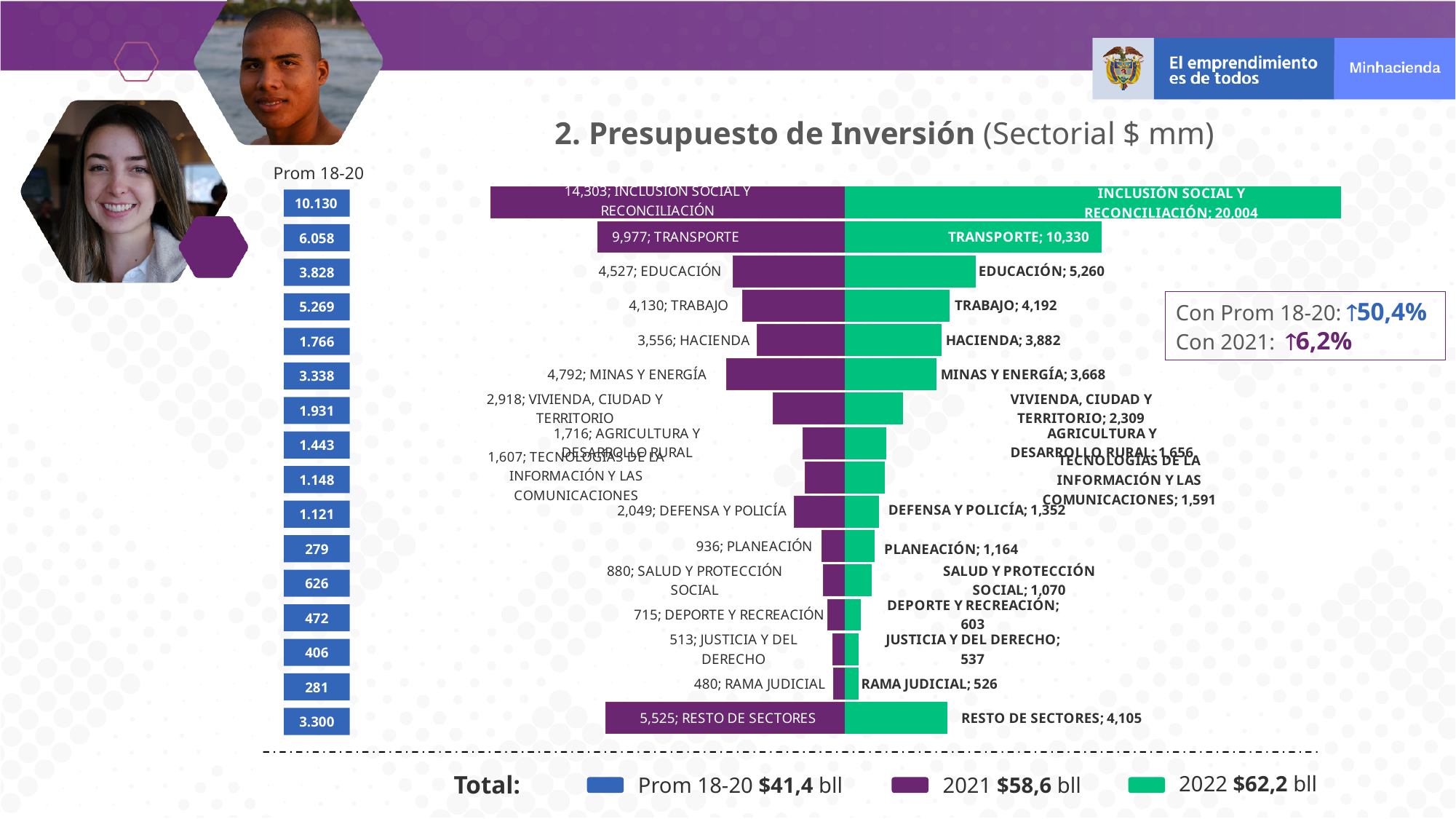
What is the difference between the 2022 and 2021 values for INCLUSIÓN SOCIAL Y RECONCILIACIÓN? 5,701 What kind of chart is used to show the sector values? Bar chart Which is larger for PLANEACIÓN, the 2021 value or the 2022 value? 2022 Which sector has the highest 2022 value? INCLUSIÓN SOCIAL Y RECONCILIACIÓN What total is shown for 2022 in the legend? $62,2 bll What is the 2021 value for EDUCACIÓN? 4,527 Which is larger for MINAS Y ENERGÍA, the 2021 value or the 2022 value? 2021 What is the 2022 value for TRANSPORTE? 10,330 What is the 2022 value for HACIENDA? 3,882 How many series does the legend at the bottom list? 3 Which sector has the lowest 2021 value? RAMA JUDICIAL How many sectors are shown in the chart? 16